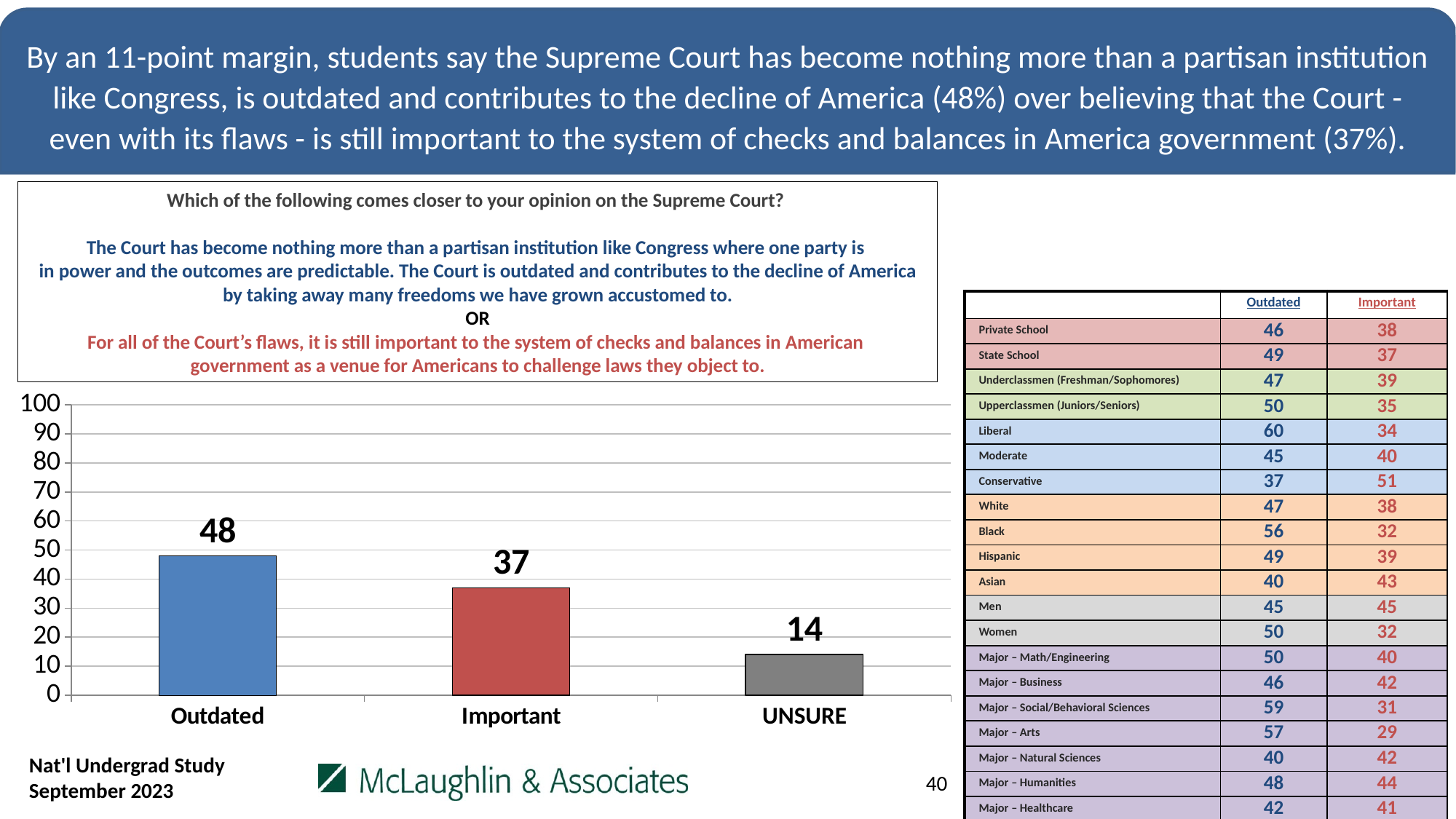
What is the maximum value shown on the vertical axis of the bar chart? 100 What is the difference between the Outdated and Important values in the bar chart? 11 What kind of chart is shown on the slide? bar chart What is the value for UNSURE in the bar chart? 14 What is the value for Important in the bar chart? 37 Which category has the highest value in the bar chart? Outdated Is the value for UNSURE in the bar chart greater or less than 20? less What is the difference between the Important and UNSURE values in the bar chart? 23 Which is larger in the bar chart, Outdated or Important? Outdated What is the value for Outdated in the bar chart? 48 Which category has the lowest value in the bar chart? UNSURE How many categories are shown in the bar chart? 3